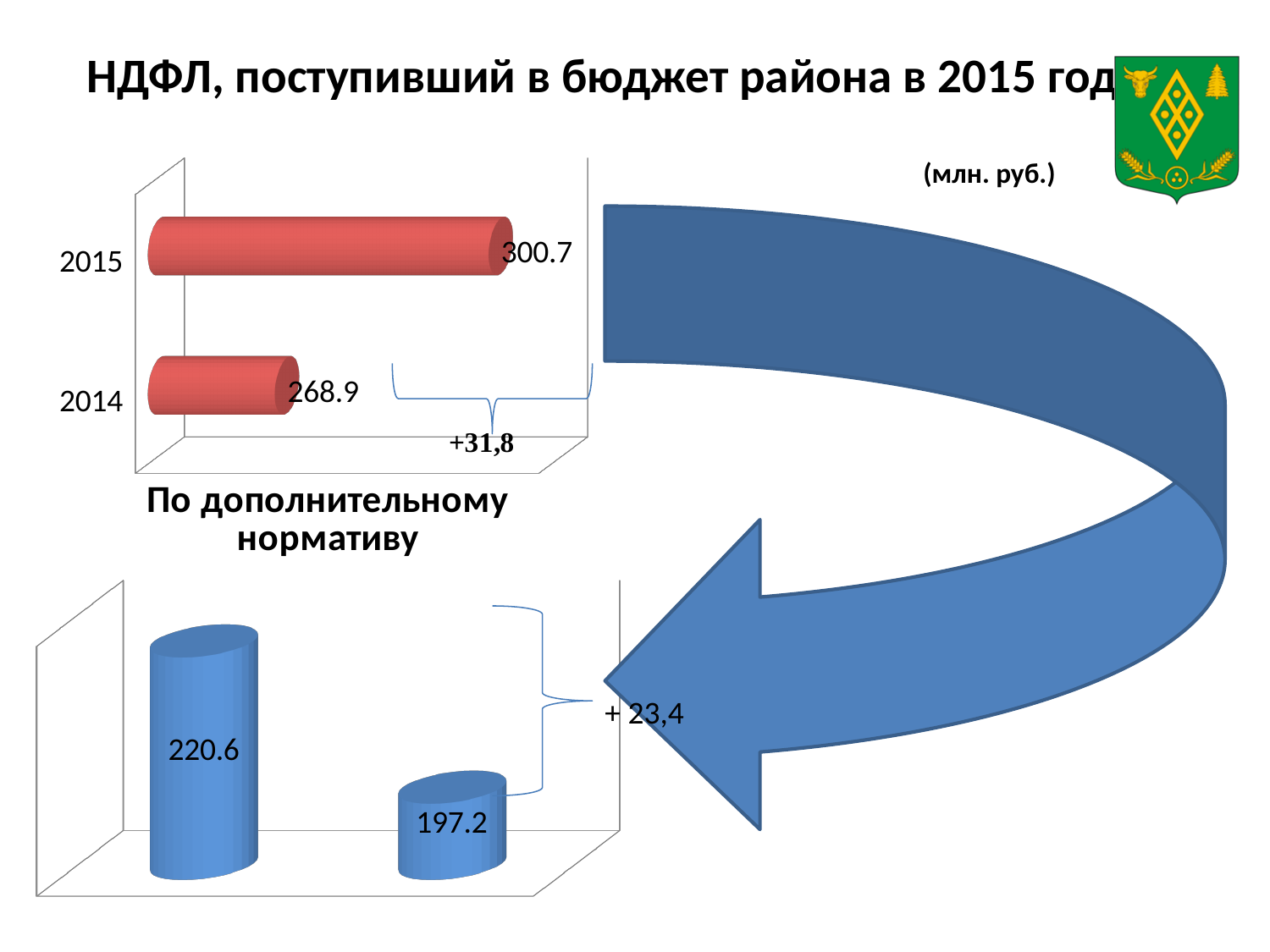
In the top chart, what is the value for 2015? 300.7 In the bottom chart, what is the value of the left bar? 220.6 In the top chart, which year has the higher value? 2015 In the bottom chart, which bar is larger, the left or the right? left What kind of chart is the top chart? bar chart In the bottom chart, what is the difference between the left bar and the right bar? 23.4 In the bottom chart, what is the value of the right bar? 197.2 What is the title of the slide containing the charts? НДФЛ, поступивший в бюджет района в 2015 год In the top chart, how many categories are plotted? 2 In the top chart, what is the difference between the 2015 and 2014 values? 31.8 In the top chart, what is the value for 2014? 268.9 In the top chart, which year has the lower value? 2014